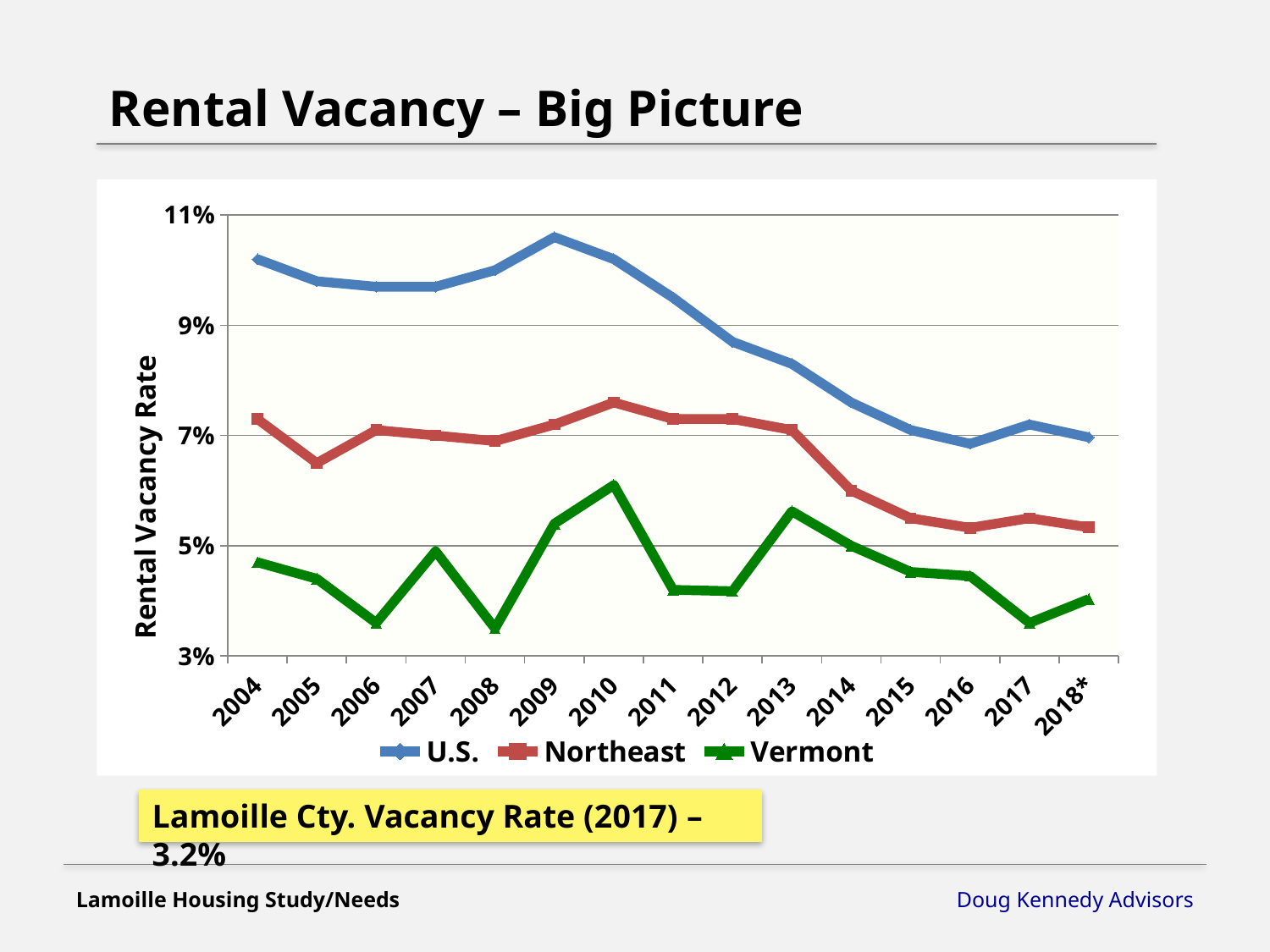
Is the U.S. value for 2013 greater or less than 9%? less What kind of chart is shown on the slide? line chart In which year does the U.S. series reach its highest value? 2009 In which year does the Vermont series reach its highest value? 2010 Does the U.S. series rise or fall from 2009 to 2016? fall Which series has the highest rental vacancy rate across all years? U.S. What is the title of the y axis? Rental Vacancy Rate Which is larger in 2004, the U.S. value or the Northeast value? U.S. Is the U.S. value for 2009 greater or less than 10%? greater How many years are plotted along the x axis? 15 Is the Northeast value for 2014 greater or less than 7%? less How many series does the legend list? 3